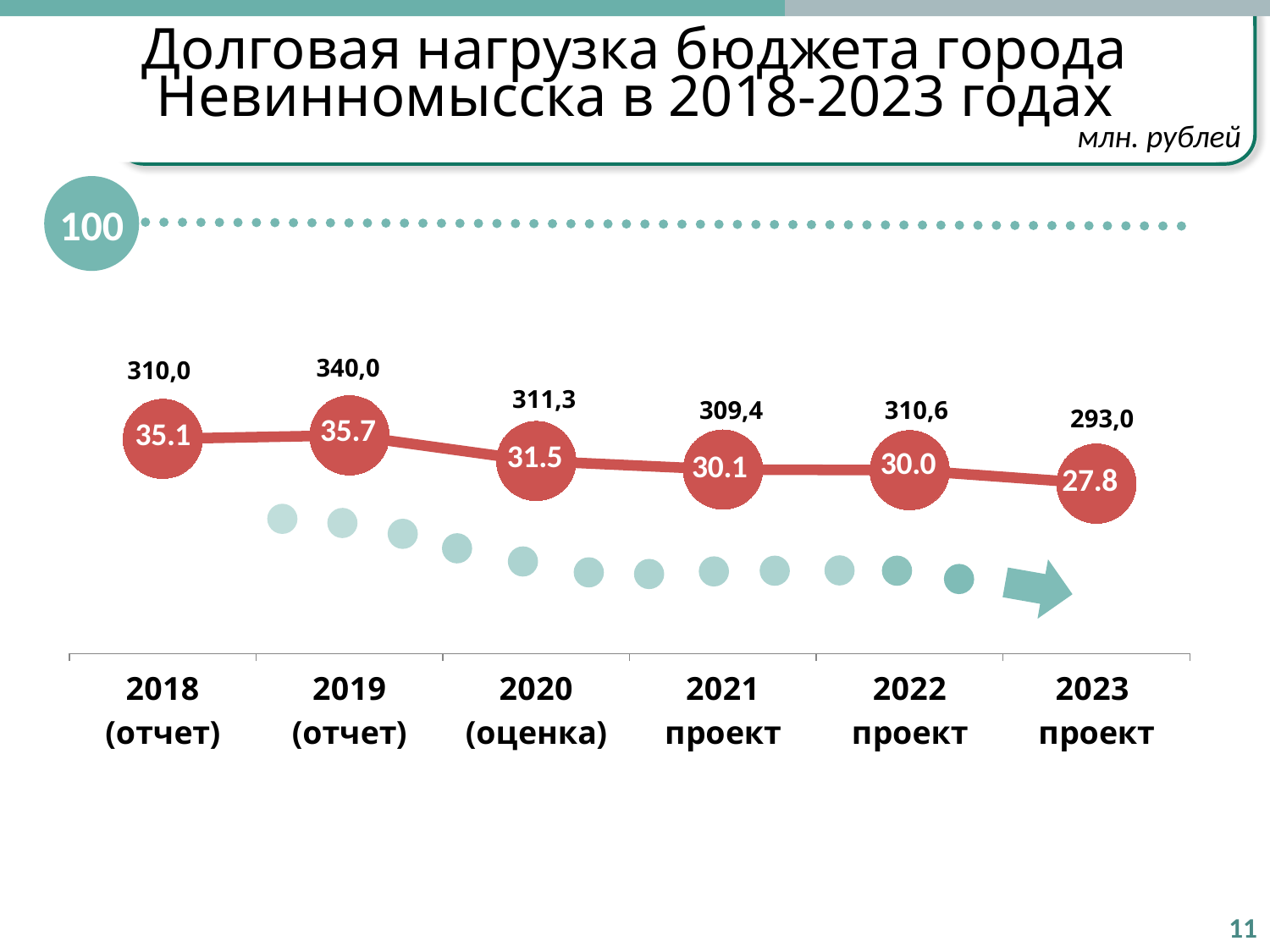
What unit is stated in the top right corner of the slide? млн. рублей How many years are plotted on the chart? 6 Which is larger, the value above the marker for 2020 (оценка) or for 2022 проект? 2020 (оценка) Do the values inside the markers generally rise or fall from 2019 to 2023? fall Which year has the highest value printed inside its marker? 2019 (отчет) What is the difference between the values inside the markers for 2019 (отчет) and 2023 проект? 7.9 What value is printed inside the marker for 2018 (отчет)? 35.1 Which year has the lowest value printed above its marker? 2023 проект What value is printed above the marker for 2019 (отчет)? 340,0 What value is printed inside the marker for 2023 проект? 27.8 What kind of chart is shown on the slide? line chart What value is printed above the marker for 2021 проект? 309,4